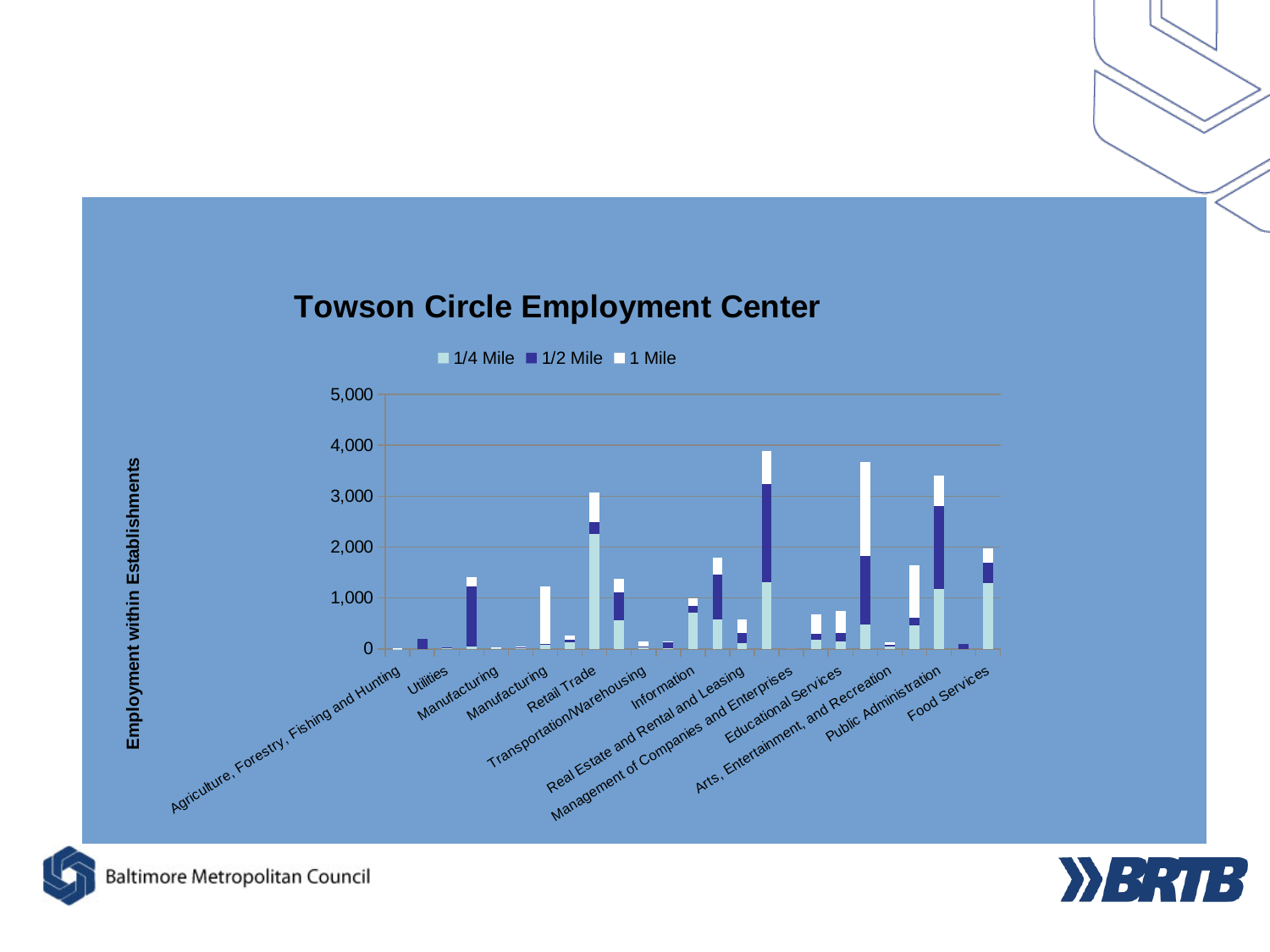
What kind of chart is shown on the slide? Stacked bar chart What is the title of the chart? Towson Circle Employment Center How many series does the legend list? 3 Is the tallest stacked bar greater or less than 4,000? less Is the tallest stacked bar greater or less than 3,000? greater What are the three series named in the legend? 1/4 Mile, 1/2 Mile, 1 Mile